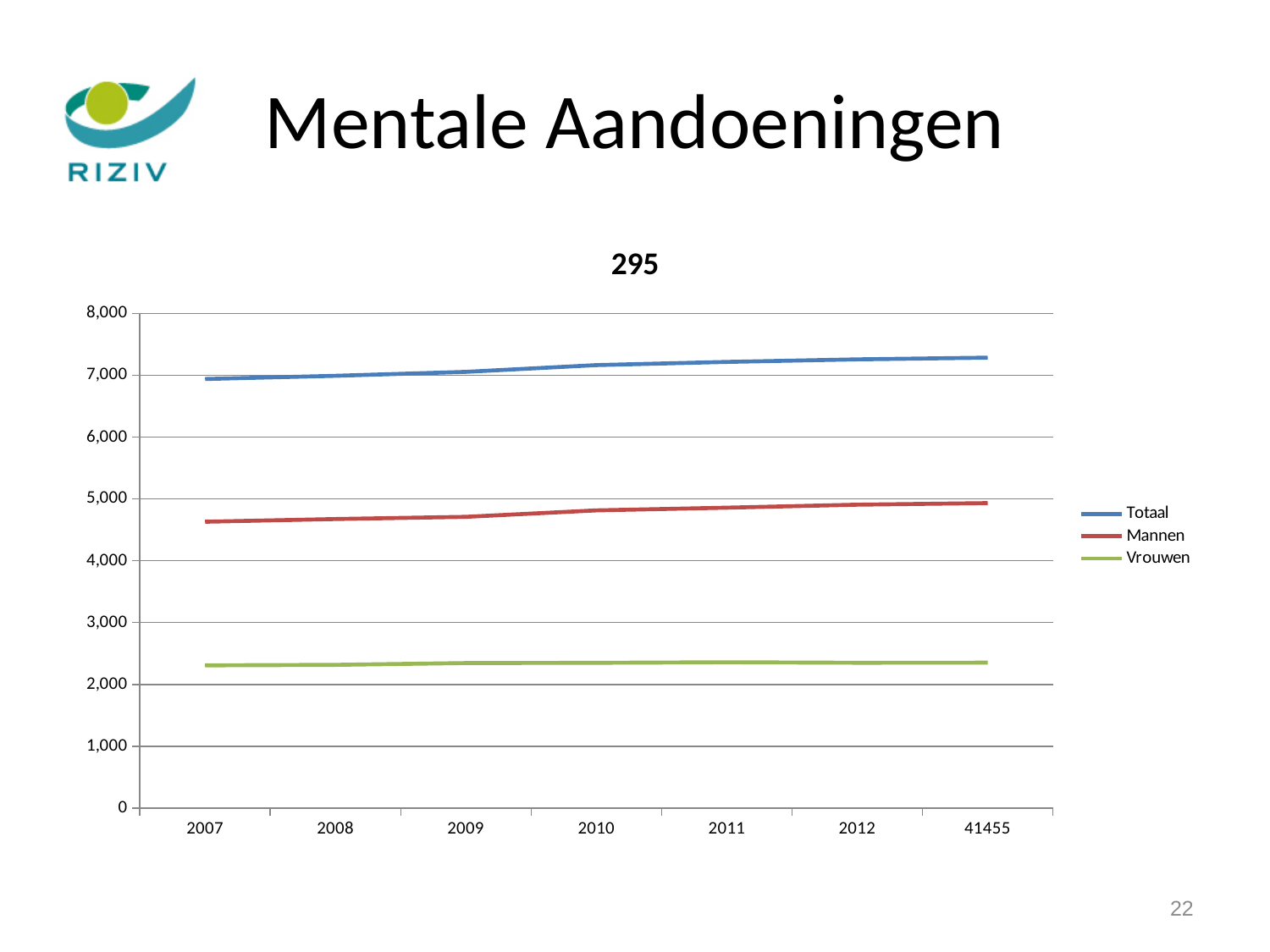
Is the value for Mannen in 2010 greater or less than 5,000? less Is the value for Vrouwen in 2007 greater or less than 2,000? greater Which series has the highest values across the chart? Totaal Which series has the lowest values across the chart? Vrouwen What kind of chart is shown on the slide? line chart How many series does the legend list? 3 Is the value for Totaal at the last x-axis point (41455) greater or less than 7,000? greater How many points are plotted along the x axis for each series? 7 Does the Totaal series rise or fall from 2007 to the last point on the x axis? rise What is the title shown above the chart? 295 In 2010, which is larger: the value for Mannen or the value for Vrouwen? Mannen